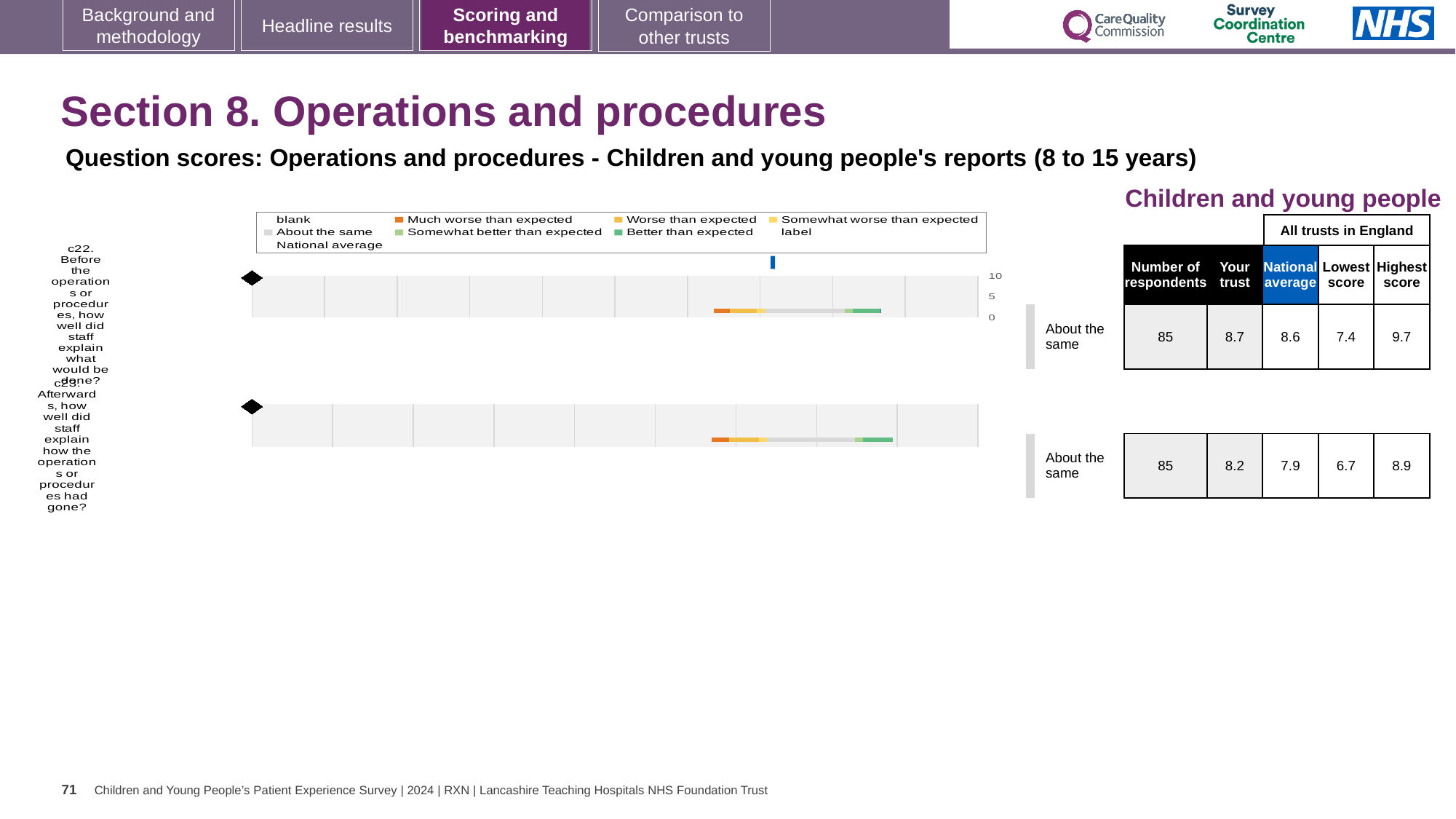
How many survey questions are charted on the slide? 2 Which benchmark category is the trust placed in for question c23? About the same What is the national average score for question c23 (Afterwards, how well did staff explain how the operations or procedures had gone?)? 7.9 In the chart legend, which colour represents 'Much worse than expected'? Orange What is the lowest score across all trusts in England for question c23? 6.7 Which question has the higher 'Your trust' score, c22 or c23? c22 What is the difference between the highest and lowest scores for question c23? 2.2 What is the highest score across all trusts in England for question c22? 9.7 What kind of chart is used to show the benchmark results for c22 and c23? bar chart How many respondents answered question c22? 85 What is the 'Your trust' score for question c22 (Before the operations or procedures, how well did staff explain what would be done?)? 8.7 By how much does the trust's score for c22 exceed the national average for c22? 0.1